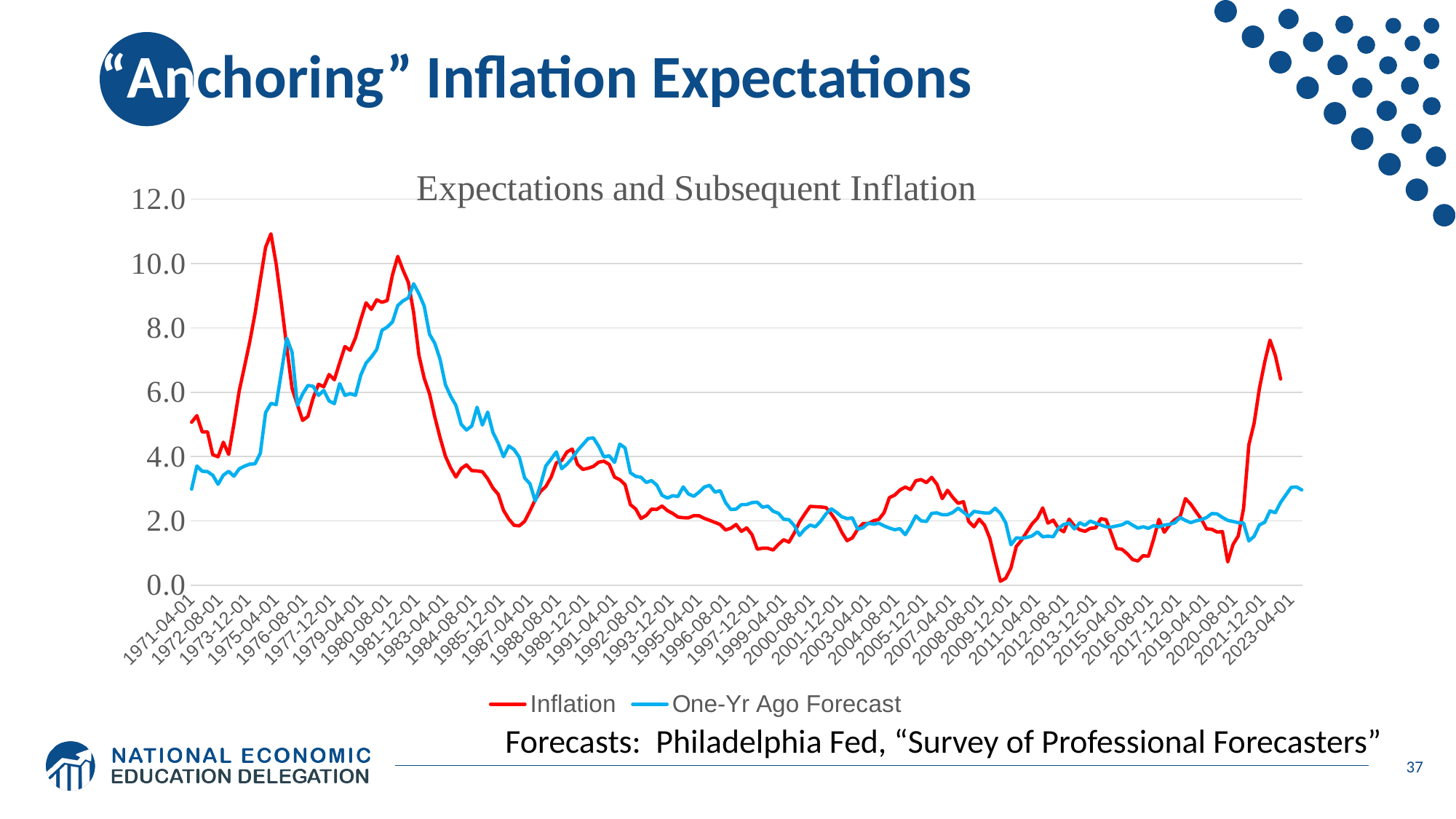
Is the lowest value reached by the Inflation series greater or less than 1.0? less Does the Inflation series rise or fall between 1981-12-01 and 1987-04-01? fall How many series does the legend list? 2 Which series reaches the higher peak value, Inflation or One-Yr Ago Forecast? Inflation At the left-hand end of the chart (1971-04-01), which series has the higher value, Inflation or One-Yr Ago Forecast? Inflation What kind of chart is shown on the slide? line chart Is the highest value reached by the Inflation series greater or less than 10.0? greater Is the lowest value reached by the One-Yr Ago Forecast series greater or less than 2.0? less Which colour is used for the Inflation series? red What is the title of the chart? Expectations and Subsequent Inflation